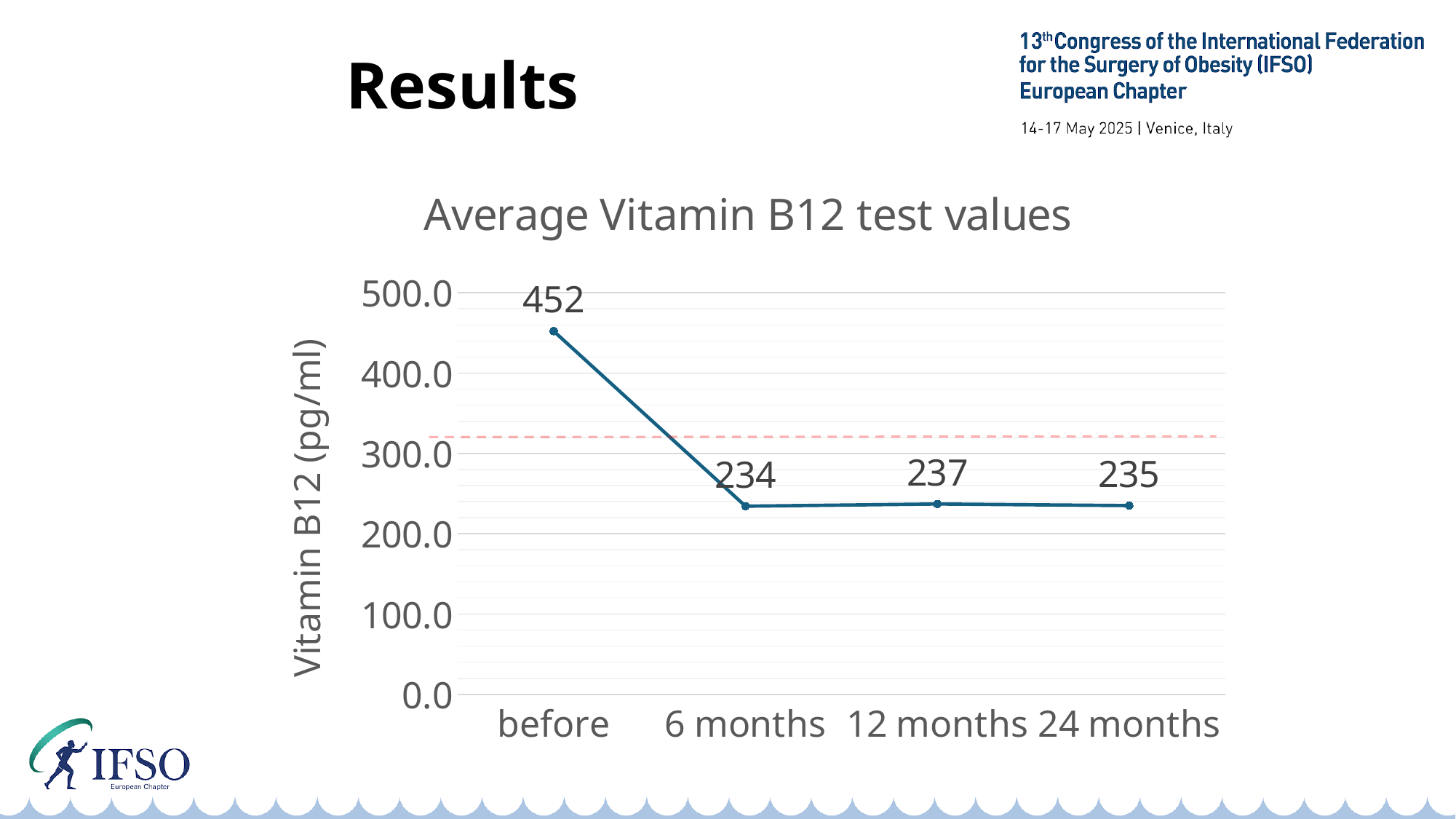
Is the average Vitamin B12 value before surgery greater or less than 400.0? greater What is the average Vitamin B12 value at 24 months? 235 Which time point has the highest average Vitamin B12 value? before What kind of chart is shown on the slide? line chart What is the average Vitamin B12 value at 6 months? 234 Is the average Vitamin B12 value at 24 months greater or less than 300.0? less How many time points are plotted on the chart? 4 What is the title of the chart? Average Vitamin B12 test values What is the average Vitamin B12 value before surgery? 452 Which time point has the lowest average Vitamin B12 value? 6 months What is the difference between the average Vitamin B12 value before and at 6 months? 218 What is the average Vitamin B12 value at 12 months? 237